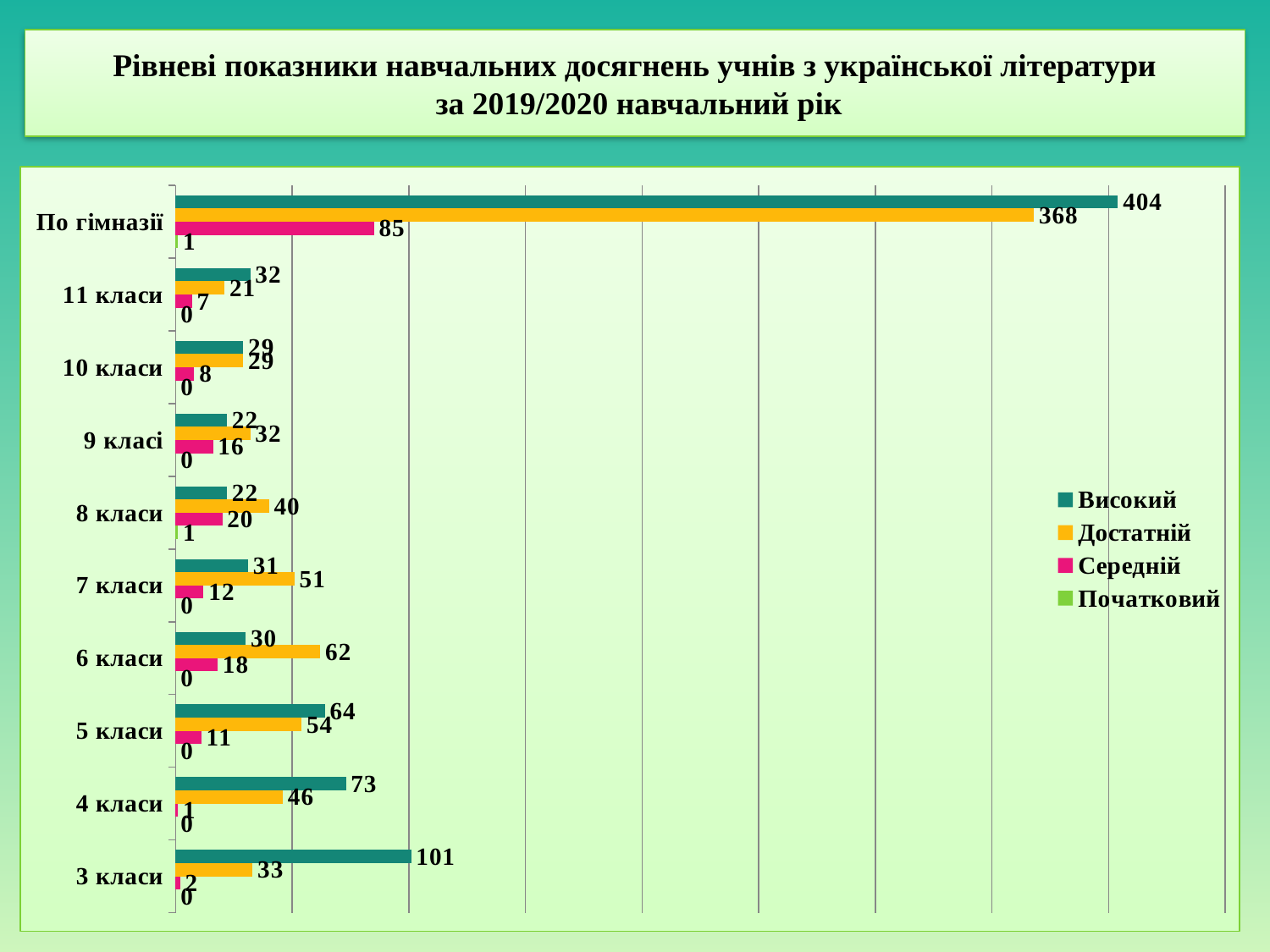
What is the value of the Початковий series for 8 класи? 1 What is the difference between the Високий and Достатній values for По гімназії? 36 What is the value of the Середній series for По гімназії? 85 How many categories are shown on the chart? 10 How many series does the legend list? 4 Which category has the highest value in the Достатній series? По гімназії What is the value of the Достатній series for 6 класи? 62 Which series is shown in pink on the chart? Середній What kind of chart is shown on the slide? Bar chart What is the value of the Високий series for 3 класи? 101 Among the class categories (excluding По гімназії), which has the lowest value in the Високий series? 9 класі and 8 класи (both 22) Which is larger for 5 класи: the Високий value or the Достатній value? Високий